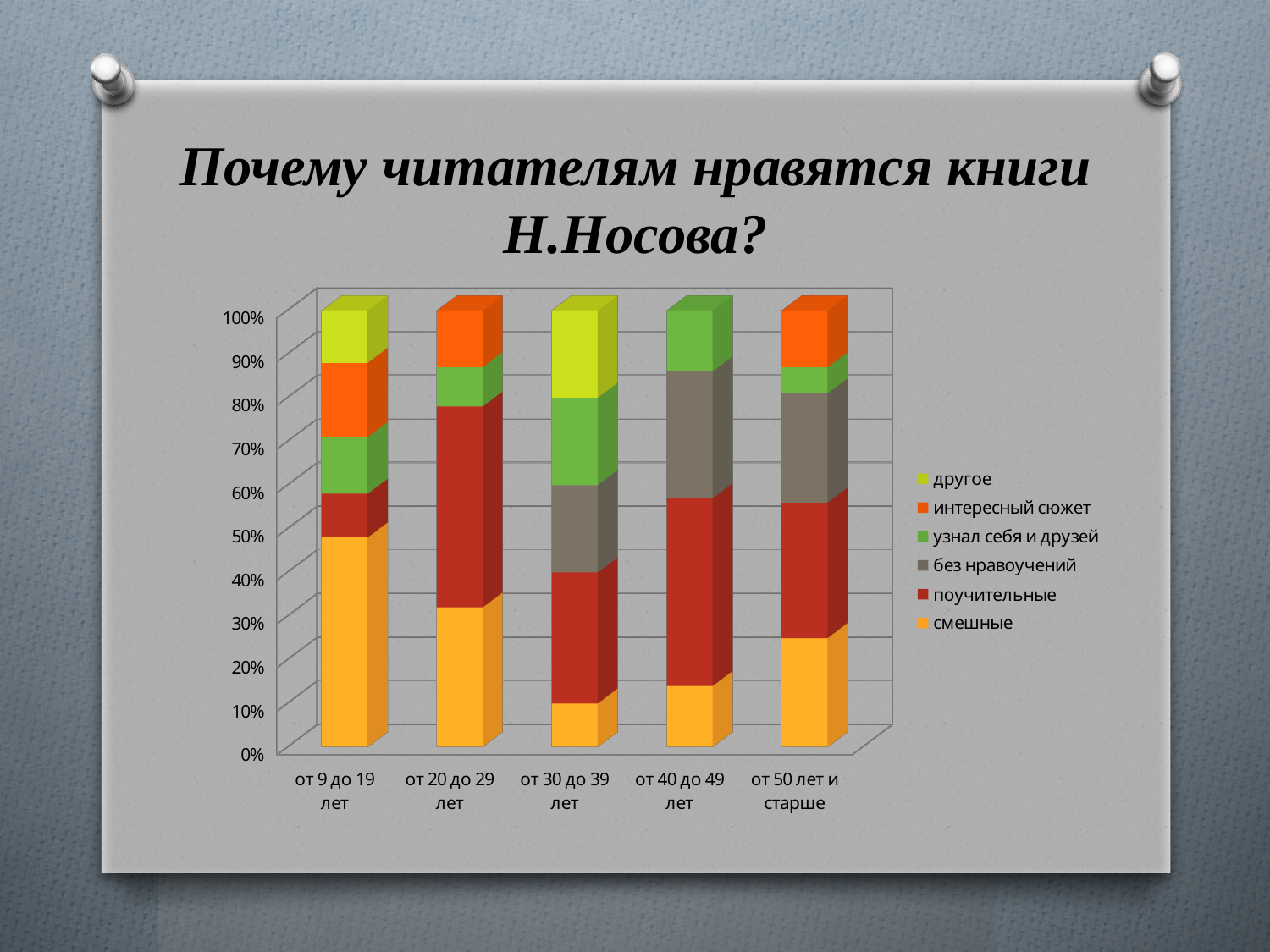
Which has a larger share of "смешные": "от 20 до 29 лет" or "от 40 до 49 лет"? от 20 до 29 лет Which has a larger share of "смешные": "от 9 до 19 лет" or "от 30 до 39 лет"? от 9 до 19 лет What kind of chart is shown on the slide? stacked bar chart Which legend entry is listed first (at the top) in the legend? другое How many age groups (categories) are shown on the x axis? 5 What is the title of the slide? Почему читателям нравятся книги Н.Носова? Which age group has the largest share for "смешные"? от 9 до 19 лет Is the share of "смешные" for "от 30 до 39 лет" greater or less than 20%? less How many series does the legend list? 6 Is the share of "смешные" for "от 9 до 19 лет" greater or less than 40%? greater Which age group has the smallest share for "смешные"? от 30 до 39 лет Is the share of "смешные" for "от 50 лет и старше" greater or less than 40%? less